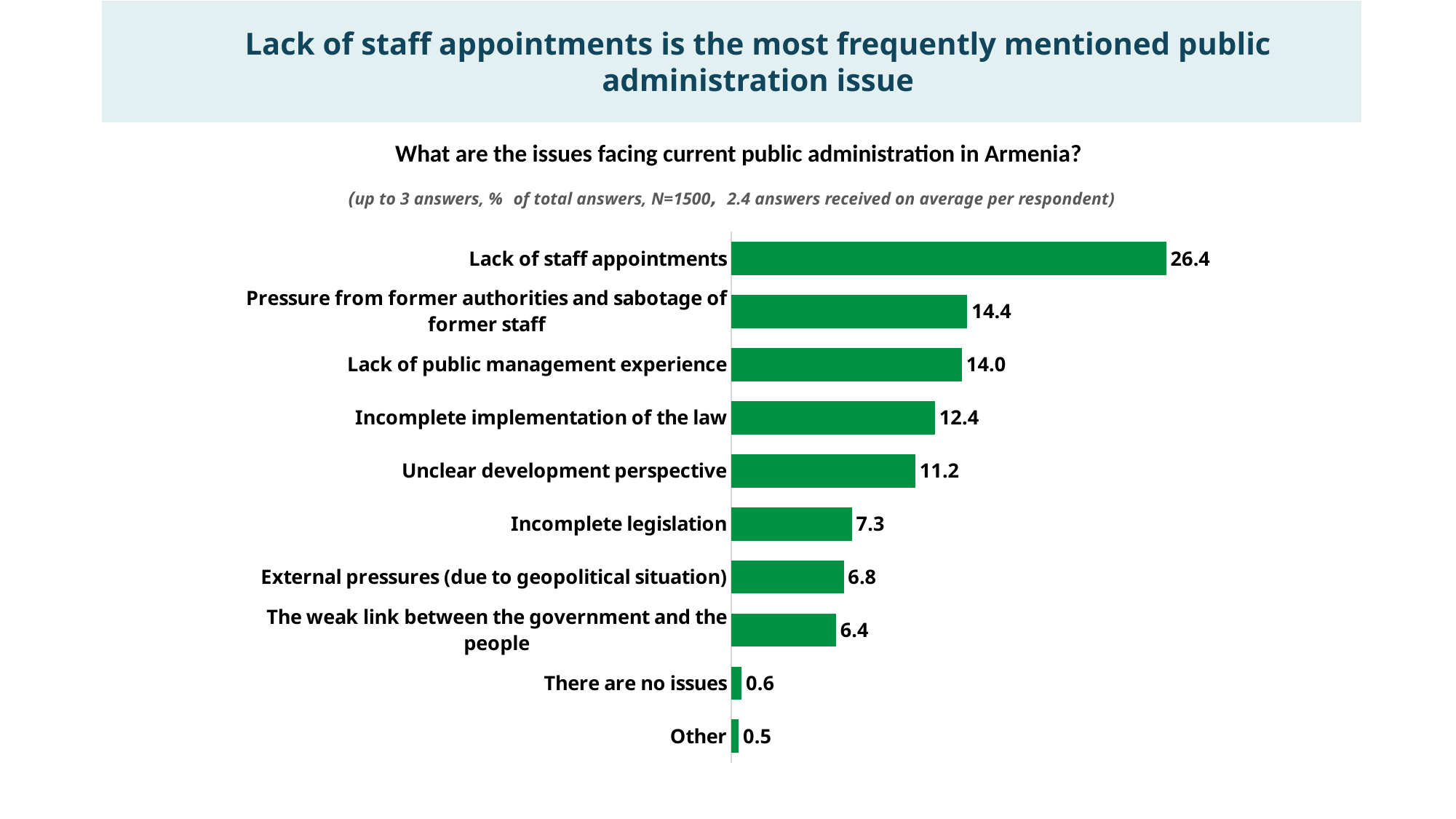
How many categories are shown in the chart? 10 What is the difference between the values for Lack of staff appointments and Pressure from former authorities and sabotage of former staff? 12.0 What kind of chart is shown on the slide? Bar chart What is the value for There are no issues? 0.6 What is the sample size (N) stated in the chart subtitle? N=1500 Which is larger: the value for Unclear development perspective or the value for Incomplete legislation? Unclear development perspective What is the difference between the values for Incomplete legislation and The weak link between the government and the people? 0.9 What is the value for Lack of staff appointments? 26.4 Which category has the highest value? Lack of staff appointments What is the value for Incomplete implementation of the law? 12.4 What is the value for External pressures (due to geopolitical situation)? 6.8 Which category has the lowest value? Other